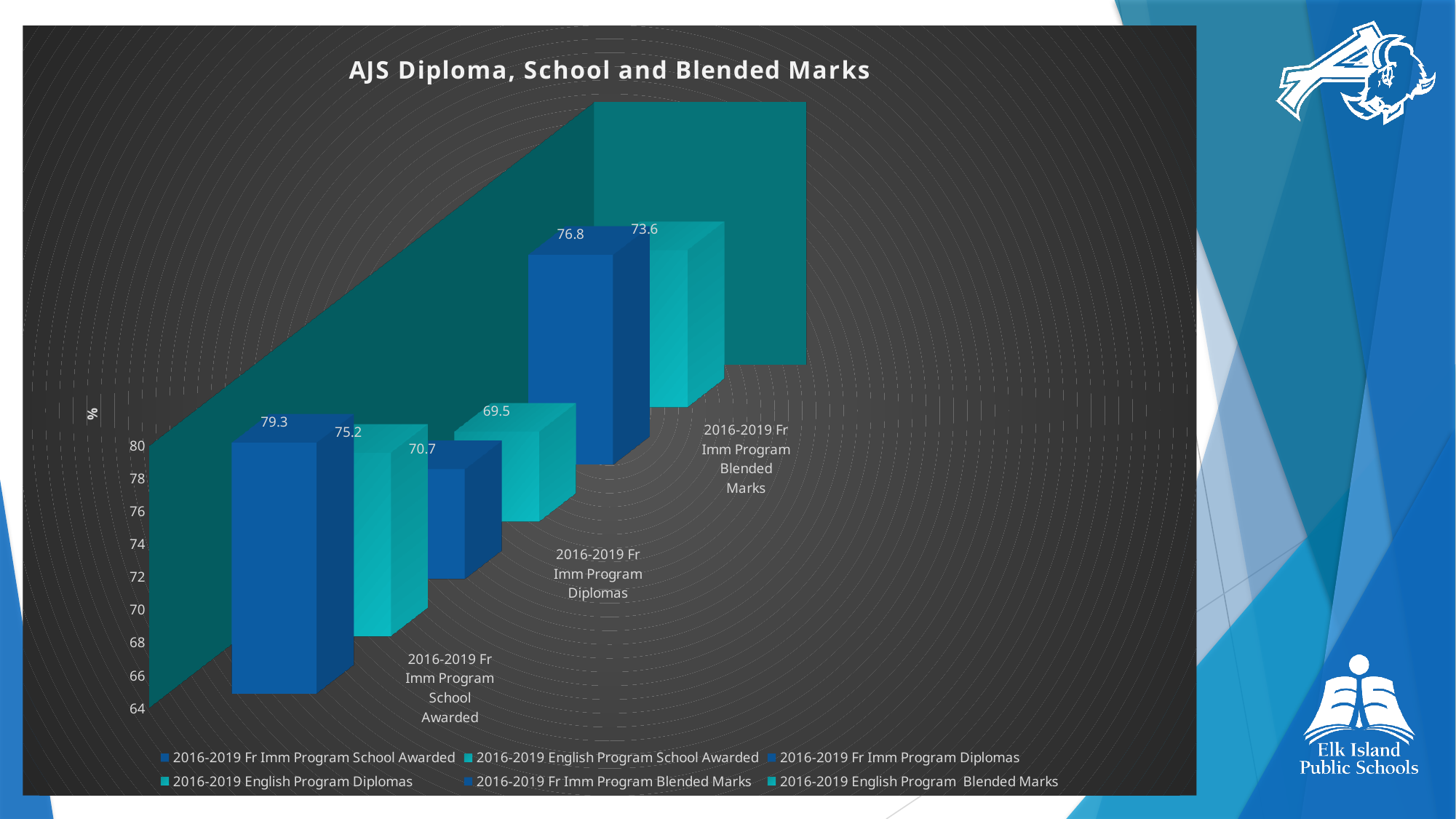
What is the value of the 2016-2019 Fr Imm Program Blended Marks bar? 76.8 What is the value of the 2016-2019 English Program Blended Marks bar? 73.6 What is the value of the 2016-2019 Fr Imm Program Diplomas bar? 70.7 What type of chart is shown on the slide? bar chart What is the title of the chart? AJS Diploma, School and Blended Marks Which is larger, the 2016-2019 Fr Imm Program Blended Marks value or the 2016-2019 English Program Blended Marks value? 2016-2019 Fr Imm Program Blended Marks What is the difference between the 2016-2019 Fr Imm Program School Awarded value and the 2016-2019 English Program School Awarded value? 4.1 What is the value of the 2016-2019 English Program Diplomas bar? 69.5 What is the value of the 2016-2019 English Program School Awarded bar? 75.2 How many series does the chart legend list? 6 Which bar has the highest value on the chart? 2016-2019 Fr Imm Program School Awarded What is the value of the 2016-2019 Fr Imm Program School Awarded bar? 79.3